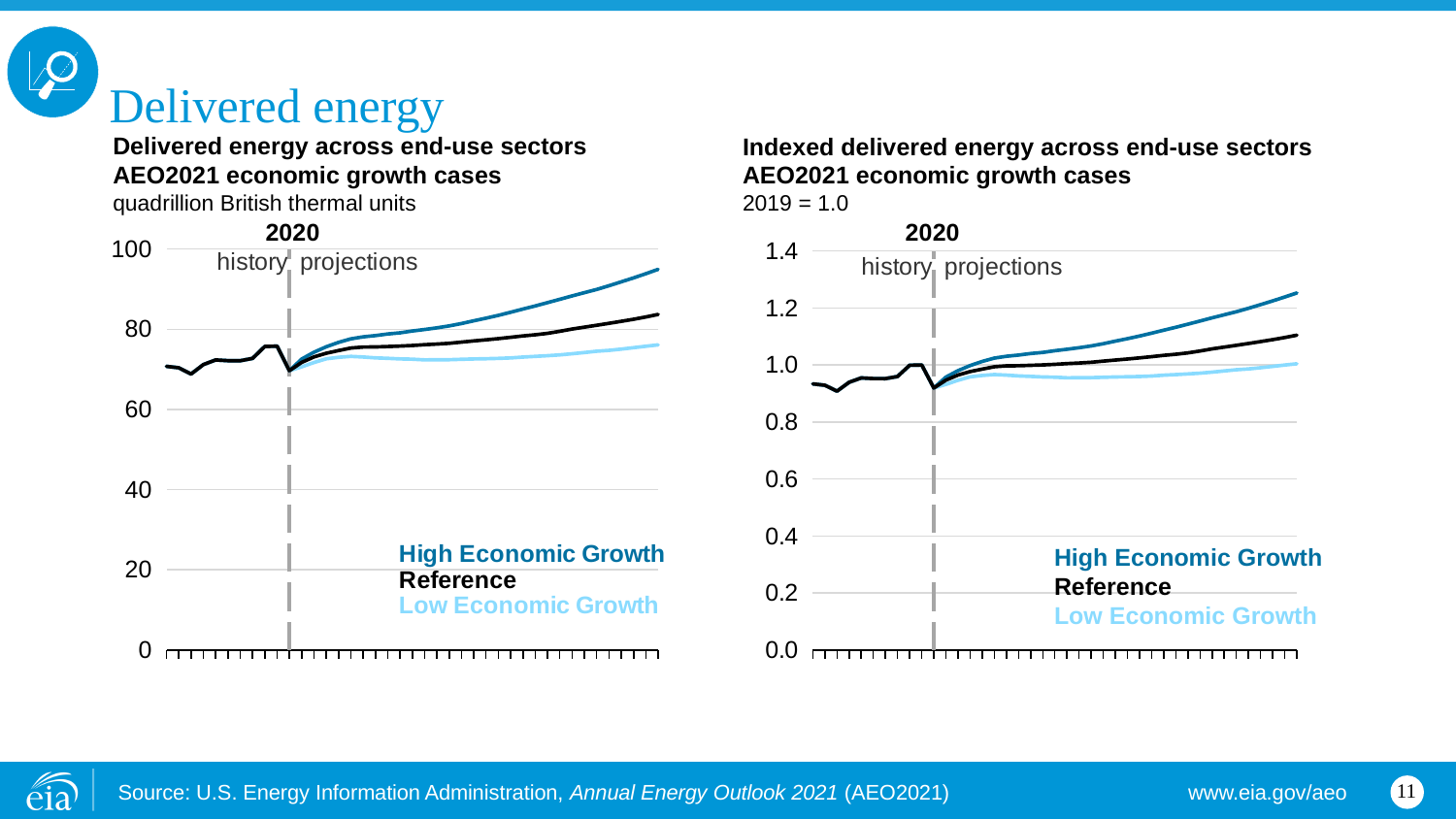
What kind of chart is the left chart, 'Delivered energy across end-use sectors'? line chart In the left chart, 'Delivered energy across end-use sectors', is the final value of the Low Economic Growth series greater or less than 80? less How many series are shown in the right chart, 'Indexed delivered energy across end-use sectors'? 3 In the left chart, 'Delivered energy across end-use sectors', is the final value of the High Economic Growth series greater or less than 80? greater In the left chart, 'Delivered energy across end-use sectors', does the High Economic Growth series rise or fall over the projection period? rise In the right chart, 'Indexed delivered energy across end-use sectors', is the final value of the High Economic Growth series greater or less than 1.2? greater What unit is used on the y axis of the left chart, 'Delivered energy across end-use sectors'? quadrillion British thermal units In the left chart, 'Delivered energy across end-use sectors', which series is highest at the end of the projection period? High Economic Growth In which year does the dashed vertical line separating history from projections fall in both charts? 2020 In the right chart, 'Indexed delivered energy across end-use sectors', which is larger at the end of the projections: the Reference series or the Low Economic Growth series? Reference In the right chart, 'Indexed delivered energy across end-use sectors', which series is lowest at the end of the projection period? Low Economic Growth